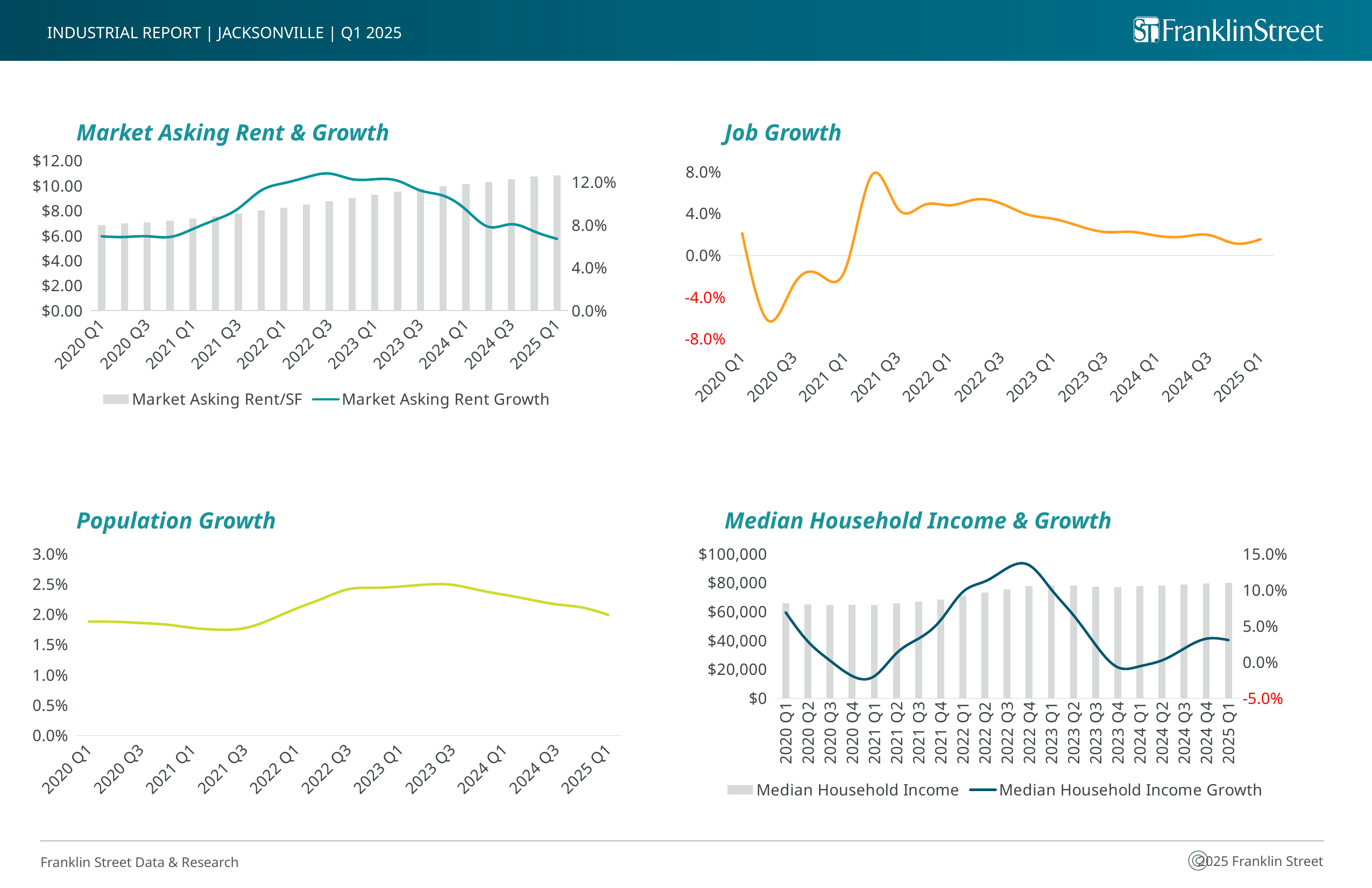
In the Market Asking Rent & Growth chart, which quarter has the higher Market Asking Rent/SF, 2020 Q1 or 2025 Q1? 2025 Q1 In the Market Asking Rent & Growth chart, how many series does the legend list? 2 In the Job Growth chart, is the lowest point of the line greater or less than -4.0%? less In the Median Household Income & Growth chart, is the Median Household Income Growth value for 2022 Q4 greater or less than 10.0%? greater In the Market Asking Rent & Growth chart, does the Market Asking Rent/SF generally rise or fall from 2020 Q1 to 2025 Q1? rise In the Job Growth chart, is the value for 2025 Q1 greater or less than 4.0%? less In the Median Household Income & Growth chart, what colour is the Median Household Income Growth line? dark blue In the Market Asking Rent & Growth chart, how many Market Asking Rent/SF bars are plotted? 21 What kind of chart is the Job Growth chart? line chart